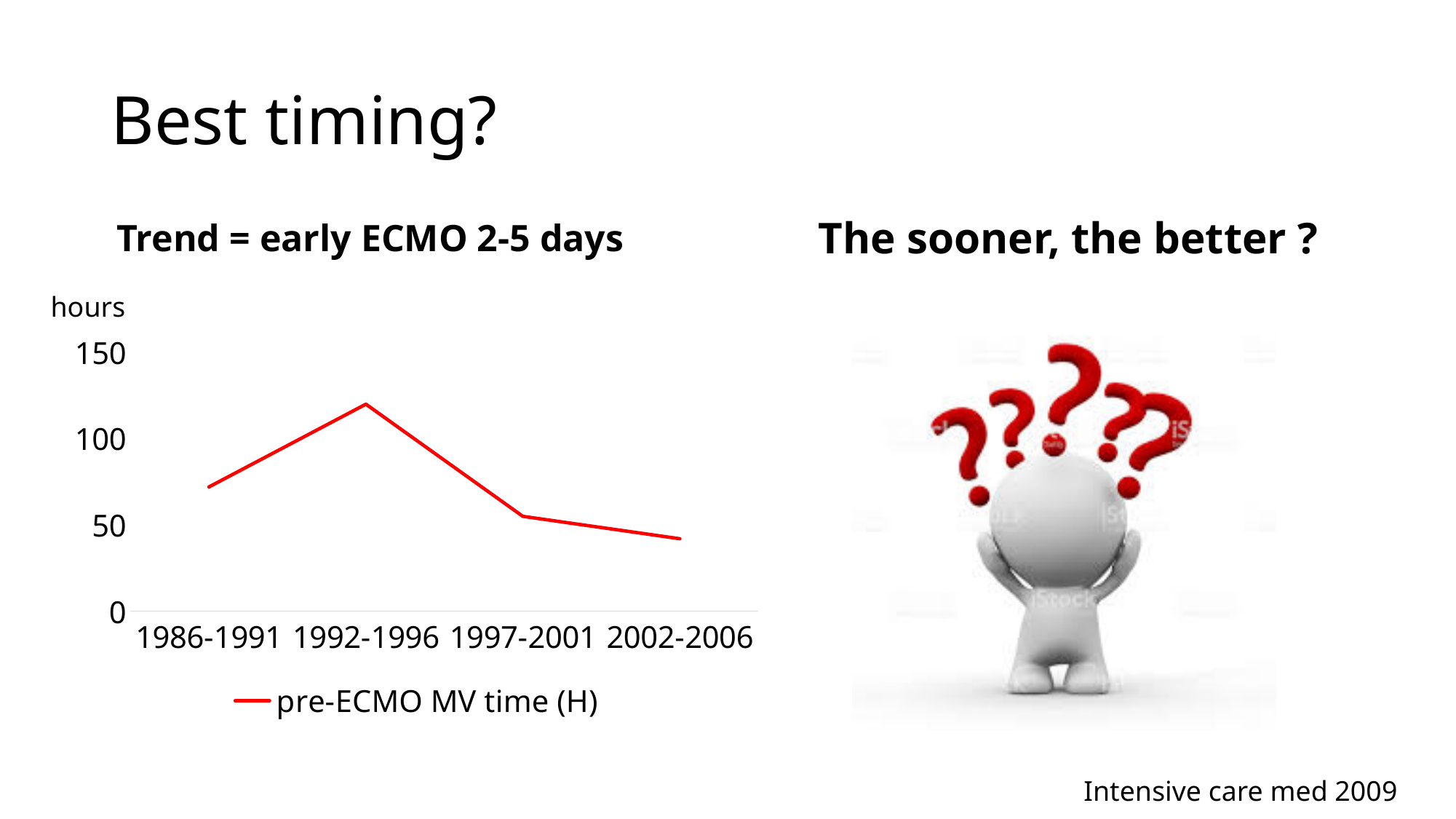
Which period has a larger pre-ECMO MV time, 1986-1991 or 1997-2001? 1986-1991 What is the name of the series shown in the chart's legend? pre-ECMO MV time (H) From 1992-1996 onward, do the pre-ECMO MV time values rise or fall along the x axis? fall How many time periods are plotted on the x axis of the chart? 4 Which period has the lowest pre-ECMO MV time (H)? 2002-2006 Is the pre-ECMO MV time for 1992-1996 greater or less than 100? greater Is the pre-ECMO MV time for 2002-2006 greater or less than 50? less Which period has the highest pre-ECMO MV time (H)? 1992-1996 What kind of chart is shown on the slide? line chart How many series does the chart's legend list? 1 What unit label is shown above the chart's vertical axis? hours Is the pre-ECMO MV time for 1986-1991 greater or less than 100? less